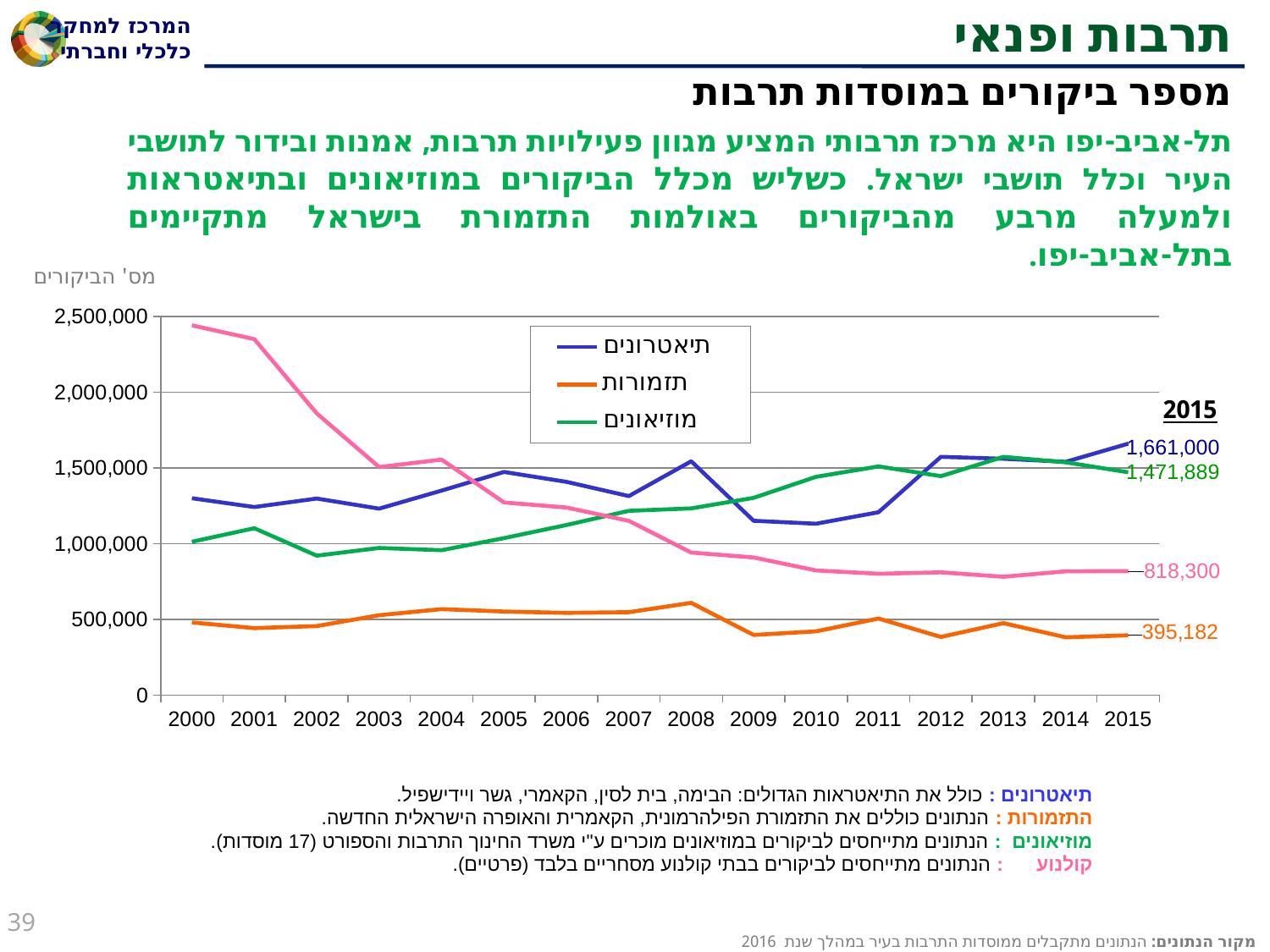
What is the difference between the 2015 values for תיאטרונים and מוזיאונים? 189,111 Which series has the lowest value in 2015? תזמורות How many years are shown on the x axis? 16 What kind of chart is shown on the slide? line chart What is the value for תיאטרונים in 2015? 1,661,000 What is the value for תזמורות in 2015? 395,182 In 2015, which is larger: the value for מוזיאונים or the value for תזמורות? מוזיאונים Which series has the highest value in 2015? תיאטרונים How many series does the legend list? 3 What is the value labelled on the pink line in 2015? 818,300 What is the value for מוזיאונים in 2015? 1,471,889 Is the value of the pink line in 2000 greater or less than 2,500,000? less